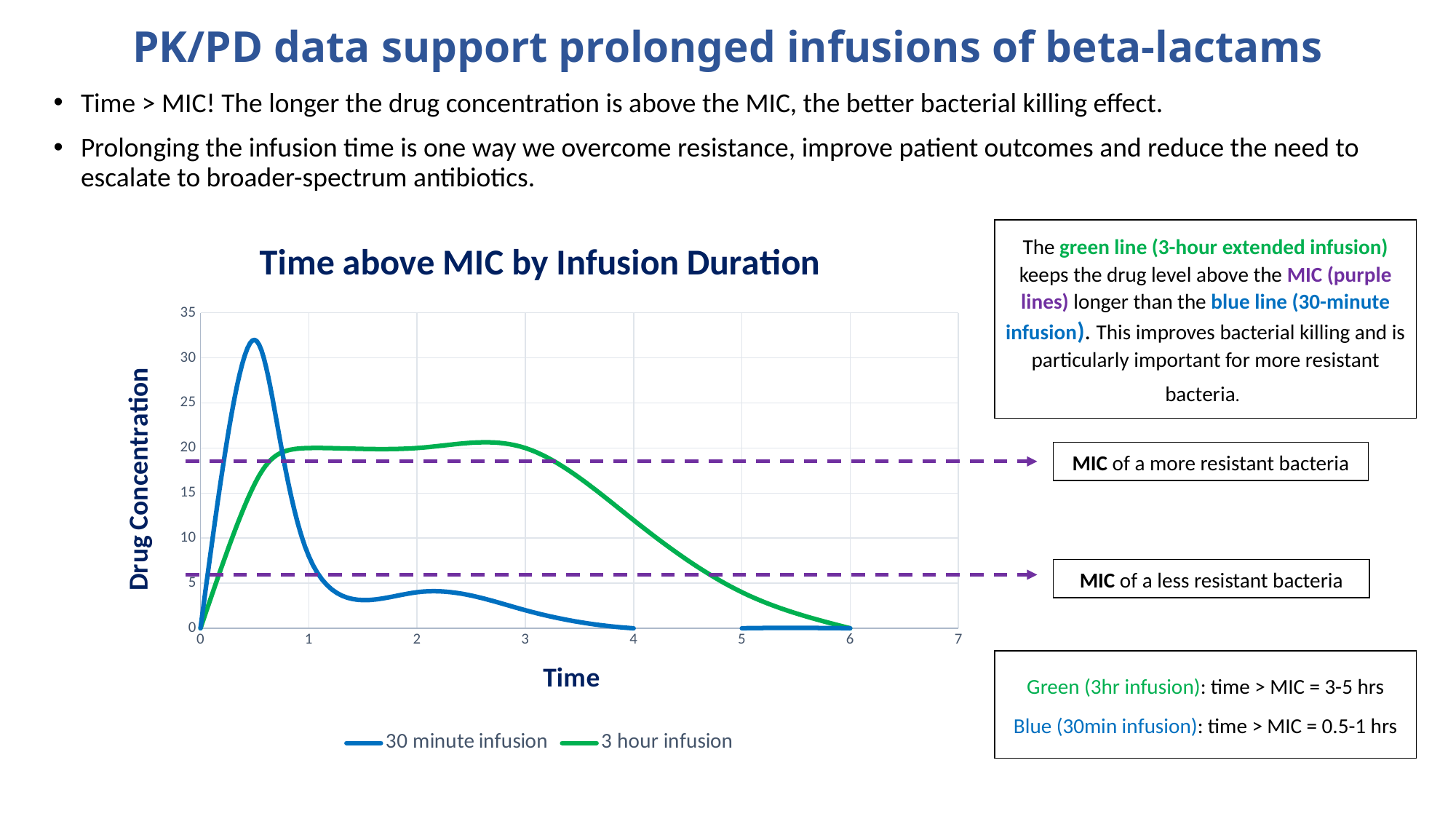
Which series reaches the higher peak drug concentration? 30 minute infusion Is the peak value of the 3 hour infusion line greater or less than 25? less What colour is the line for the 3 hour infusion series? Green How many series does the chart legend list? 2 Is the value of the 30 minute infusion line at time 3 greater or less than 5? less At time 2, which series has the higher drug concentration? 3 hour infusion Is the peak value of the 30 minute infusion line greater or less than 30? greater What is the title of the chart? Time above MIC by Infusion Duration What kind of chart is shown on the slide? Line chart